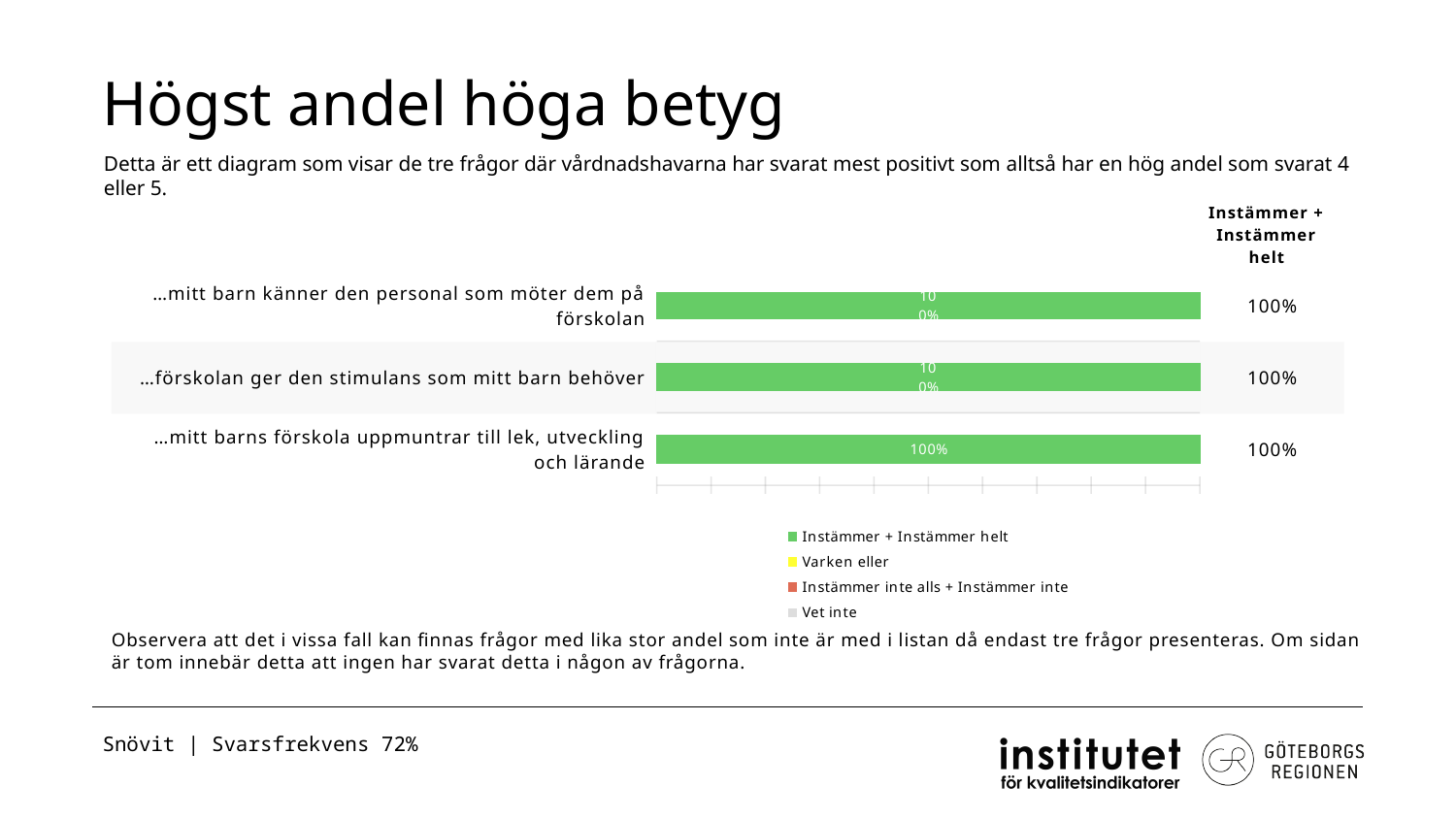
What is the difference between the 'Instämmer + Instämmer helt' values for '…förskolan ger den stimulans som mitt barn behöver' and '…mitt barns förskola uppmuntrar till lek, utveckling och lärande'? 0% What is the 'Instämmer + Instämmer helt' value for '…förskolan ger den stimulans som mitt barn behöver'? 100% What kind of chart is shown on the slide? bar chart How many series does the chart legend list? 4 How many questions (categories) are shown in the chart? 3 Which colour represents 'Instämmer + Instämmer helt' in the chart legend? green What is the total of the stacked bar for '…mitt barns förskola uppmuntrar till lek, utveckling och lärande'? 100% What is the 'Instämmer + Instämmer helt' value for '…mitt barns förskola uppmuntrar till lek, utveckling och lärande'? 100% What is the 'Instämmer + Instämmer helt' value for '…mitt barn känner den personal som möter dem på förskolan'? 100% Is the 'Instämmer + Instämmer helt' value for '…mitt barn känner den personal som möter dem på förskolan' greater or less than 50%? greater What is the title of the slide containing the chart? Högst andel höga betyg